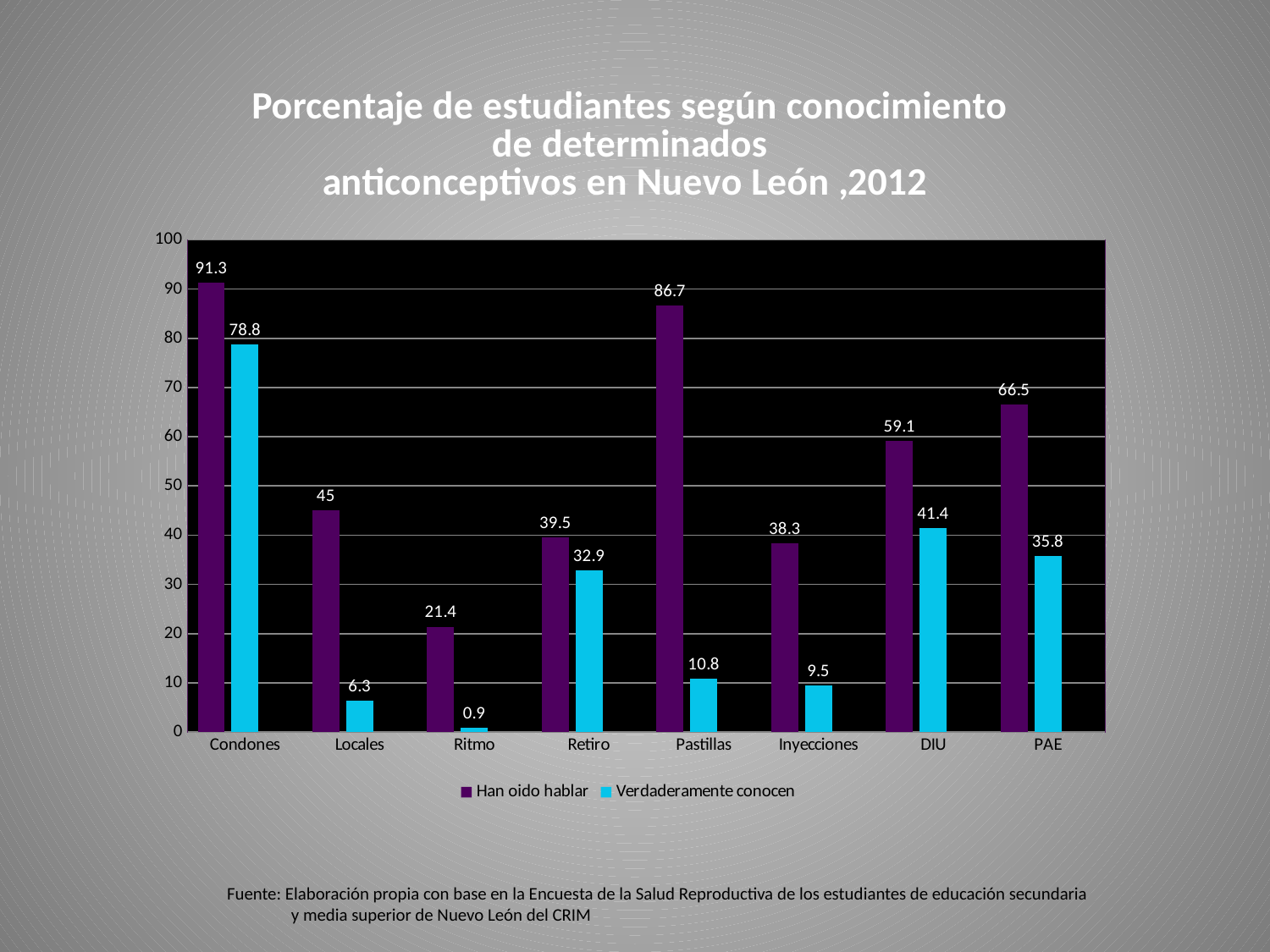
Which is larger for Retiro: 'Han oido hablar' or 'Verdaderamente conocen'? Han oido hablar Which category has the lowest value for 'Verdaderamente conocen'? Ritmo What is the value for 'Verdaderamente conocen' for DIU? 41.4 What is the value for 'Han oido hablar' for Condones? 91.3 Is the value for 'Han oido hablar' for PAE greater or less than 60? greater How many contraceptive categories are shown on the x axis? 8 What is the difference between 'Han oido hablar' and 'Verdaderamente conocen' for Pastillas? 75.9 How many series does the legend list? 2 What colour are the bars for the 'Verdaderamente conocen' series? Cyan (light blue) Which category has the highest value for 'Han oido hablar'? Condones What is the value for 'Verdaderamente conocen' for Ritmo? 0.9 What type of chart is shown on the slide? Bar chart